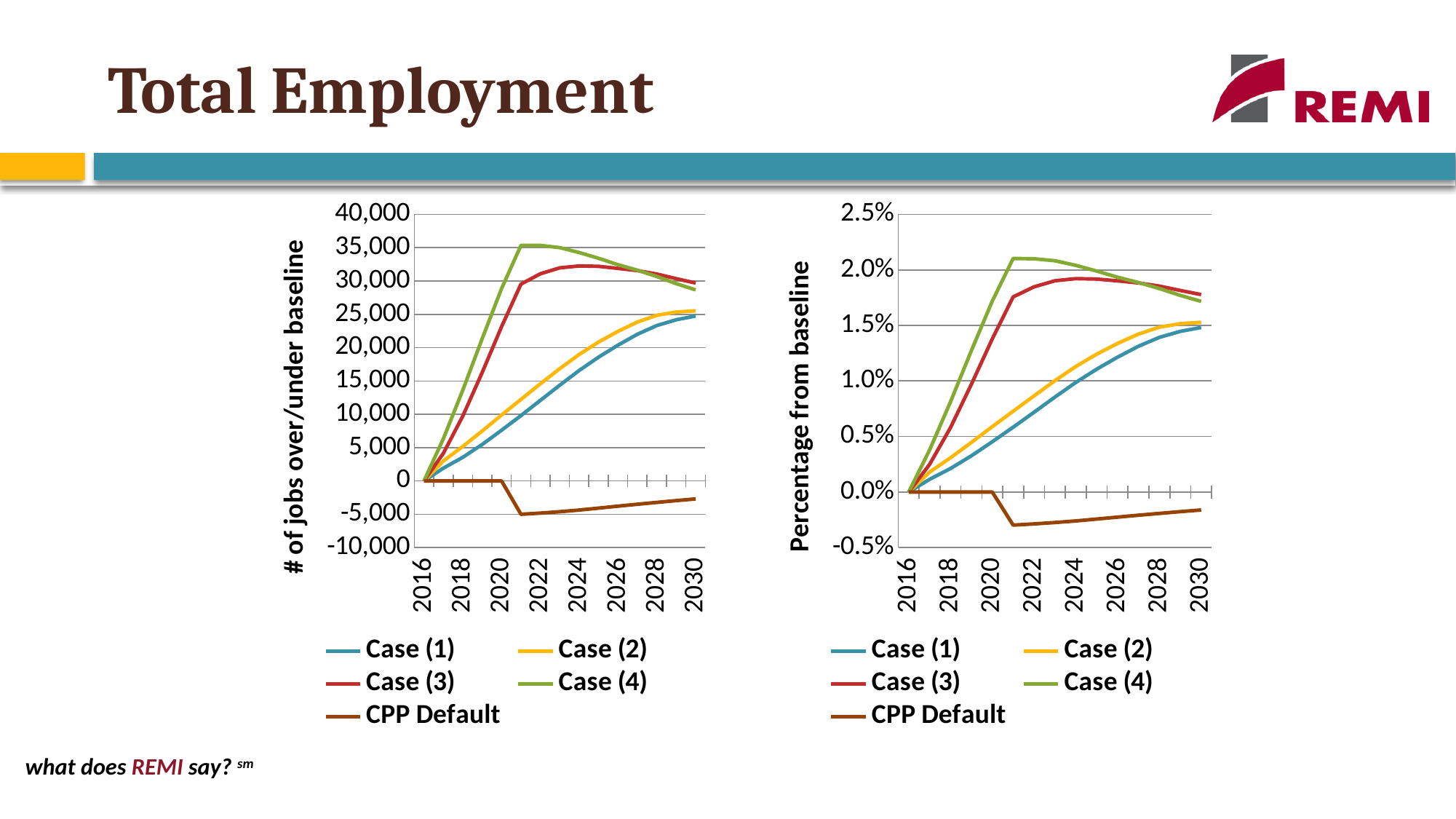
In the left chart (# of jobs over/under baseline), which is larger in 2024: Case (3) or Case (2)? Case (3) What is the y-axis title of the right chart? Percentage from baseline In the left chart (# of jobs over/under baseline), what is the value for CPP Default in 2018? 0 How many series does the legend of the left chart list? 5 In the right chart (Percentage from baseline), does the Case (4) line rise or fall from 2022 to 2030? fall In the left chart (# of jobs over/under baseline), which series has the lowest value in 2030? CPP Default In the right chart (Percentage from baseline), is the value for CPP Default in 2022 greater or less than 0.0%? less In the left chart (# of jobs over/under baseline), is the value for Case (4) in 2022 greater or less than 30,000? greater In the left chart (# of jobs over/under baseline), is the value for Case (1) in 2030 greater or less than 20,000? greater What kind of chart is the left chart (# of jobs over/under baseline)? line chart In the left chart (# of jobs over/under baseline), what is the value for Case (1) in 2016? 0 In the left chart (# of jobs over/under baseline), which series has the highest value in 2022? Case (4)